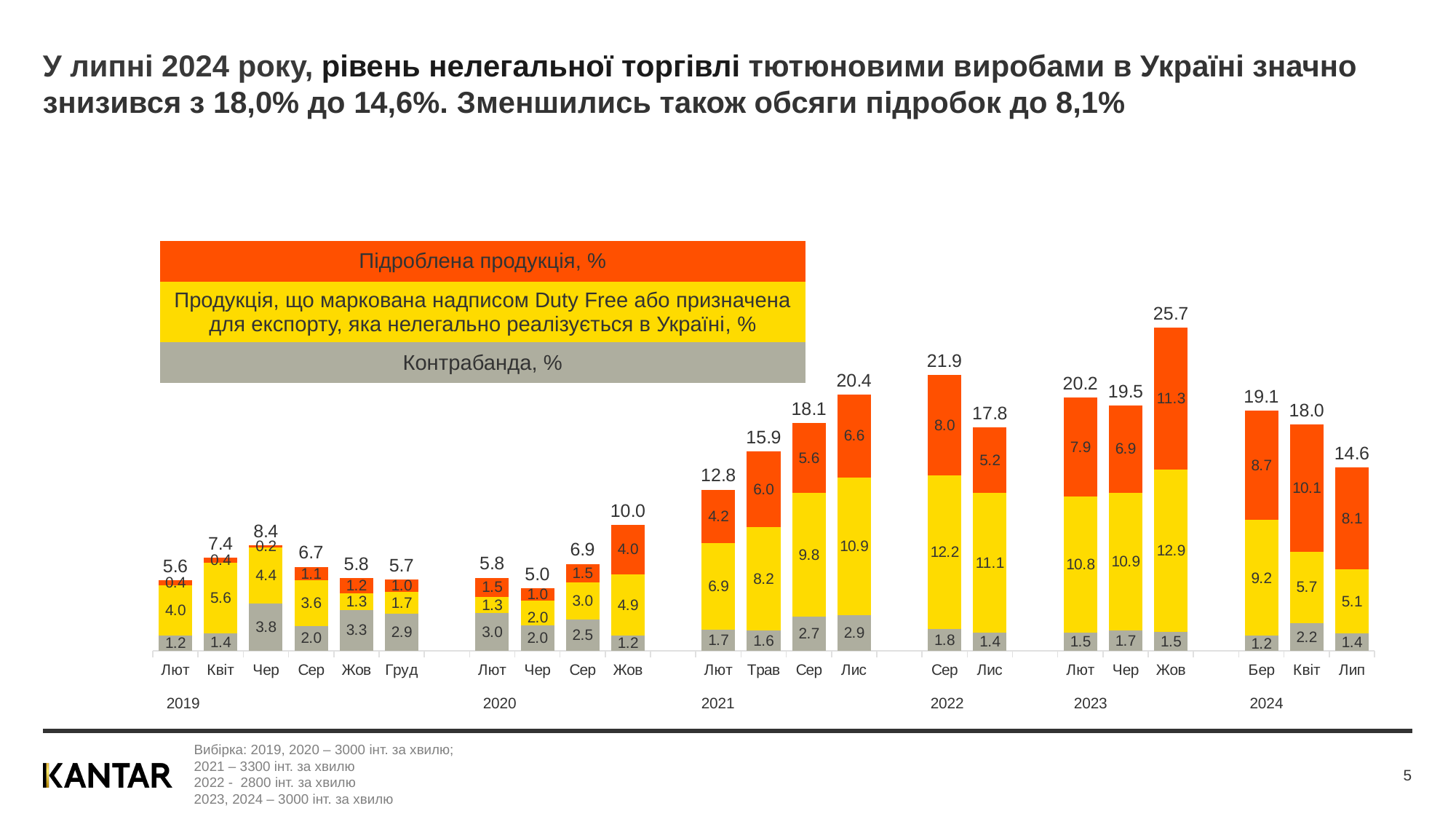
How many series does the legend list? 3 What kind of chart is shown on the slide? Stacked bar chart Which colour represents Контрабанда, % in the legend? Grey What is the total illegal trade level shown for Лип 2024? 14.6 How many bars (months) are plotted on the chart? 22 What is the value of Контрабанда, % for Чер 2019? 3.8 What is the difference between the total for Квіт 2024 and the total for Лип 2024? 3.4 Which month has the lowest total bar on the chart? Чер 2020 Which month has the highest total bar on the chart? Жов 2023 Do the total values rise or fall across the four months of 2021? Rise What is the value of Підроблена продукція, % for Квіт 2024? 10.1 Which is larger: the Duty Free/export segment for Сер 2022 or for Жов 2023? Жов 2023